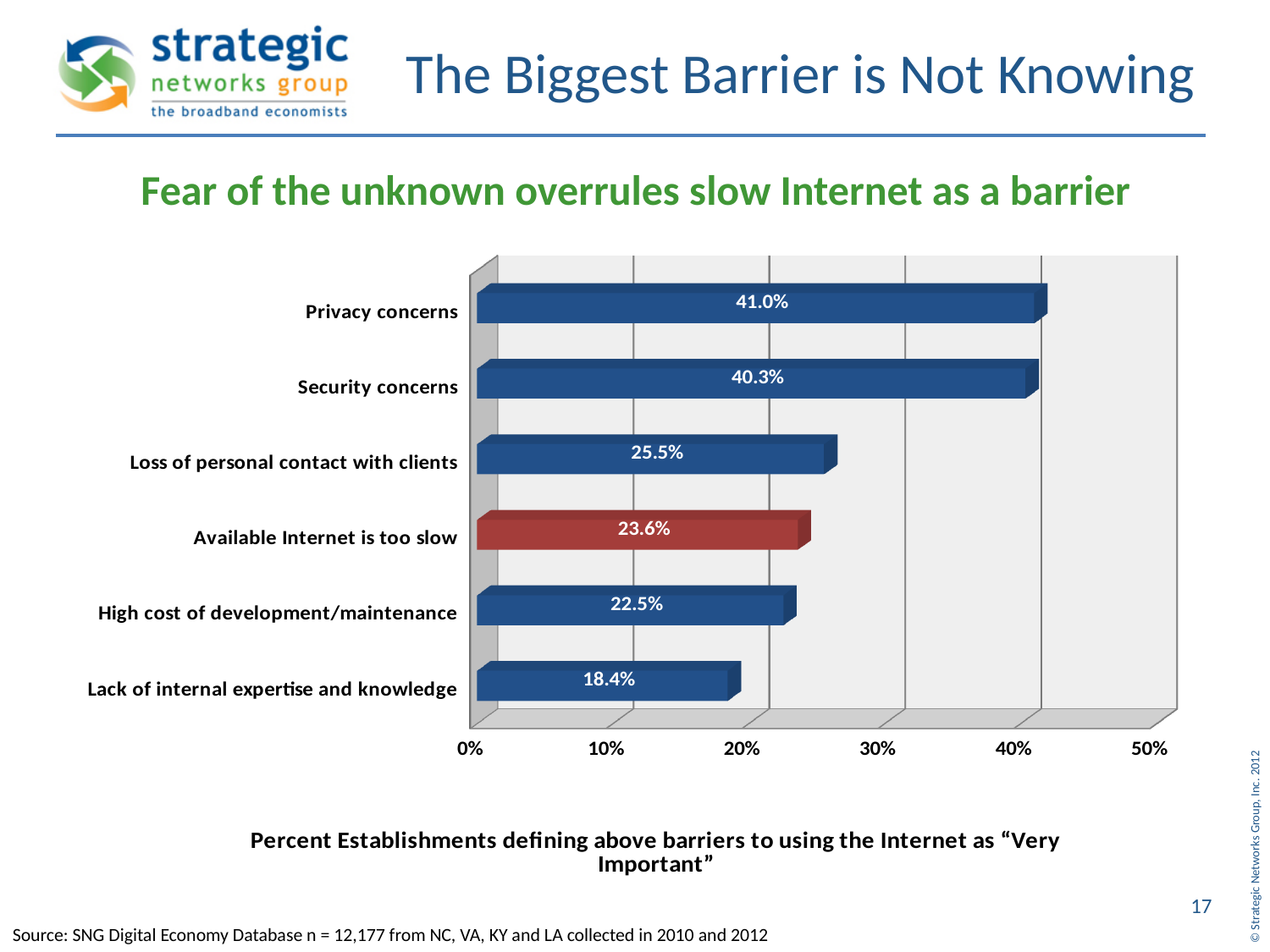
Which bar is coloured red instead of blue? Available Internet is too slow What is the value for Privacy concerns? 41.0% What kind of chart is shown on the slide? Bar chart What is the difference between Privacy concerns and Security concerns? 0.7% Which barrier has the lowest value? Lack of internal expertise and knowledge What is the difference between Loss of personal contact with clients and Lack of internal expertise and knowledge? 7.1% How many barriers are shown in the chart? 6 Is the value for Security concerns greater or less than 30%? greater What is the value for Available Internet is too slow? 23.6% What is the value for Lack of internal expertise and knowledge? 18.4% Which barrier has the highest value? Privacy concerns Which is larger, Available Internet is too slow or High cost of development/maintenance? Available Internet is too slow